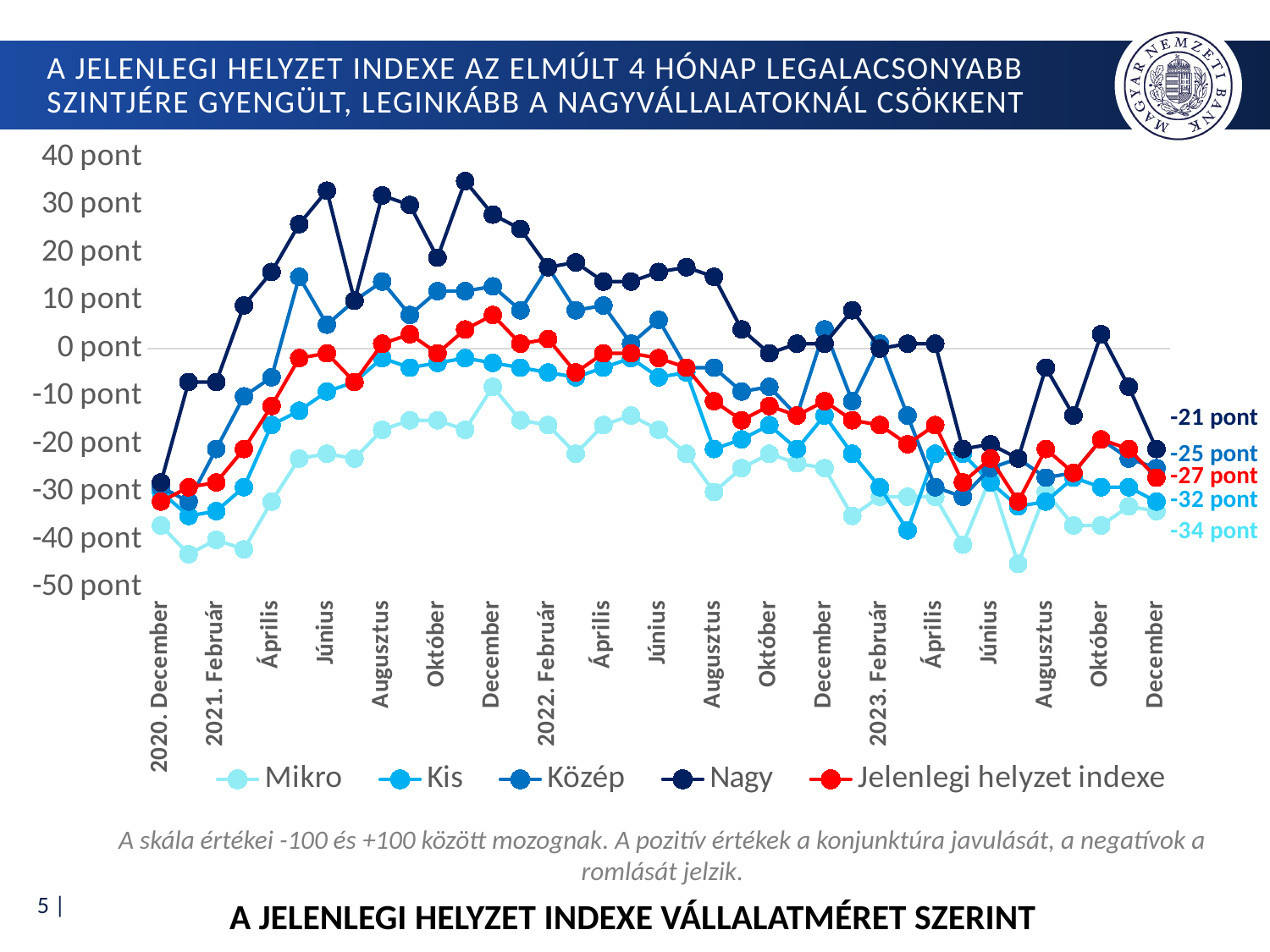
Which series has the highest value at the end of the chart (2023 December)? Nagy What is the value of the Jelenlegi helyzet indexe series at the end of the chart (2023 December)? -27 pont What colour is the Jelenlegi helyzet indexe series drawn in? red What is the value of the Mikro series at the end of the chart (2023 December)? -34 pont What is the value of the Közép series at the end of the chart (2023 December)? -25 pont What is the difference between the Nagy and Mikro values at the end of the chart (2023 December)? 13 pont What is the value of the Nagy series at the end of the chart (2023 December)? -21 pont How many series does the legend list? 5 What kind of chart is shown on the slide? line chart What is the value of the Kis series at the end of the chart (2023 December)? -32 pont Which series has the lowest value at the end of the chart (2023 December)? Mikro